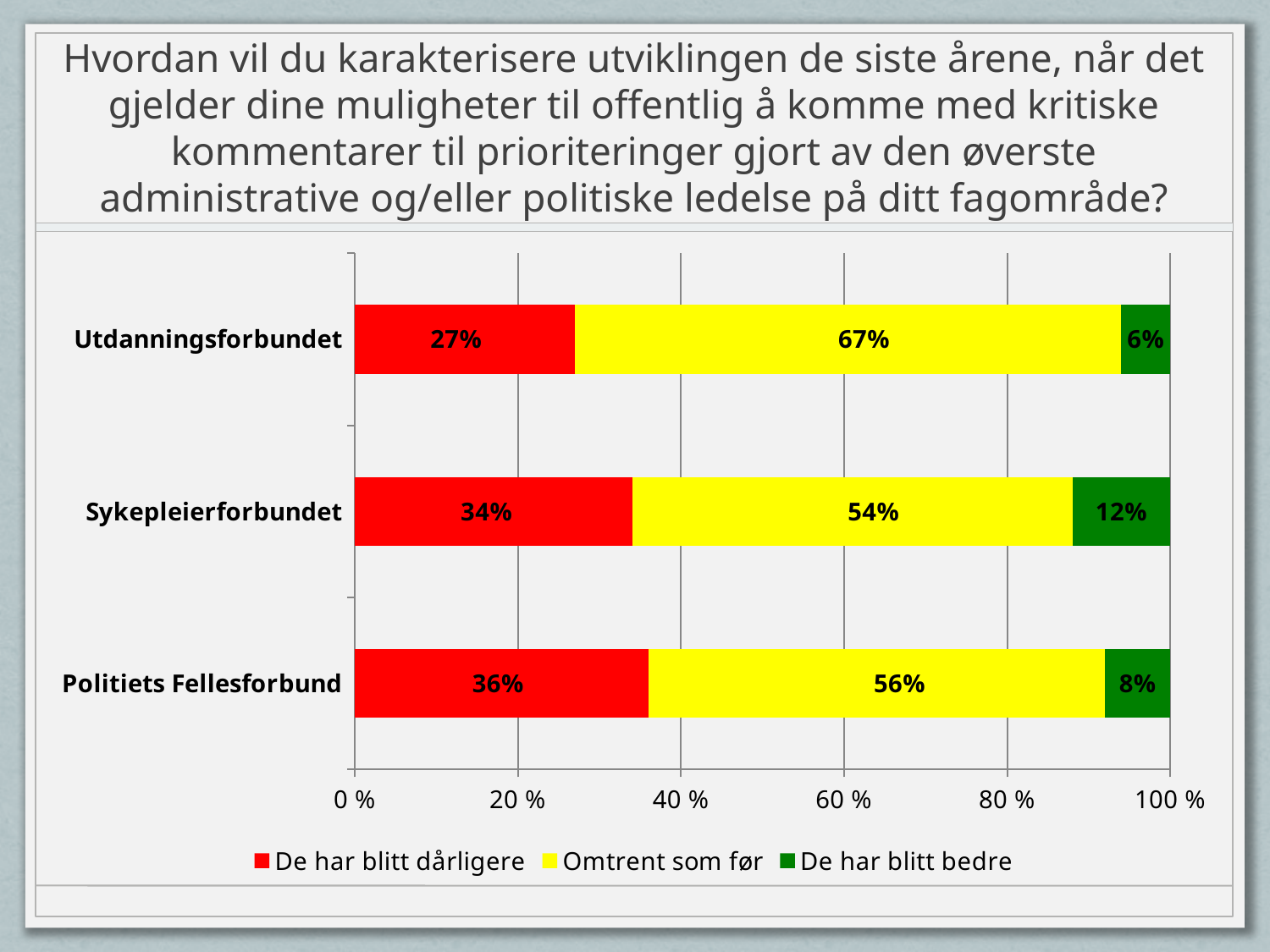
What percentage of Sykepleierforbundet respondents answered "Omtrent som før"? 54% How many categories are shown on the y axis? 3 Which colour represents "De har blitt bedre" in the legend? Green How many series does the legend list? 3 What percentage of Politiets Fellesforbund respondents answered "De har blitt bedre"? 8% What kind of chart is shown on the slide? Stacked bar chart What is the difference between the "De har blitt dårligere" shares for Politiets Fellesforbund and Utdanningsforbundet? 9 percentage points Which category has the lowest share for "De har blitt bedre"? Utdanningsforbundet What percentage of Utdanningsforbundet respondents answered "De har blitt dårligere"? 27% Which category has the highest share for "Omtrent som før"? Utdanningsforbundet Which is larger: the "De har blitt bedre" share for Sykepleierforbundet or for Politiets Fellesforbund? Sykepleierforbundet What is the total of the stacked bar for Sykepleierforbundet? 100%